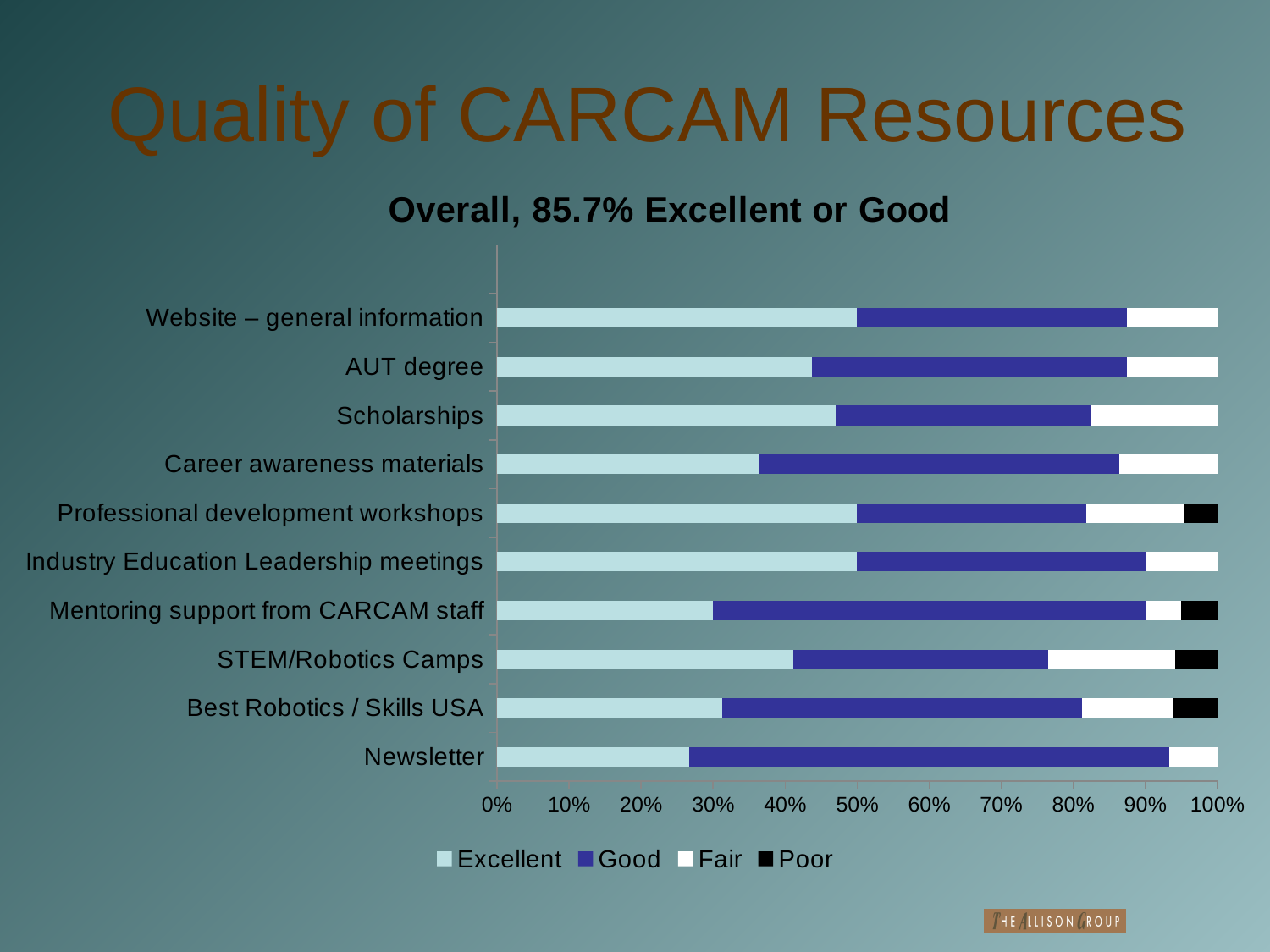
What are the four rating series listed in the legend? Excellent, Good, Fair, Poor How many resource categories show a Poor segment? 4 What is the total of the stacked bar for Newsletter? 100% How many series does the legend list? 4 Is the Excellent share for Career awareness materials greater or less than 40%? less What is the title shown above the chart? Overall, 85.7% Excellent or Good What kind of chart is shown on the slide? Stacked bar chart Is the Excellent share for Scholarships greater or less than 50%? less Which has a larger Excellent share, Newsletter or Career awareness materials? Career awareness materials Is the Excellent share for Newsletter greater or less than 30%? less How many resource categories are listed on the chart? 10